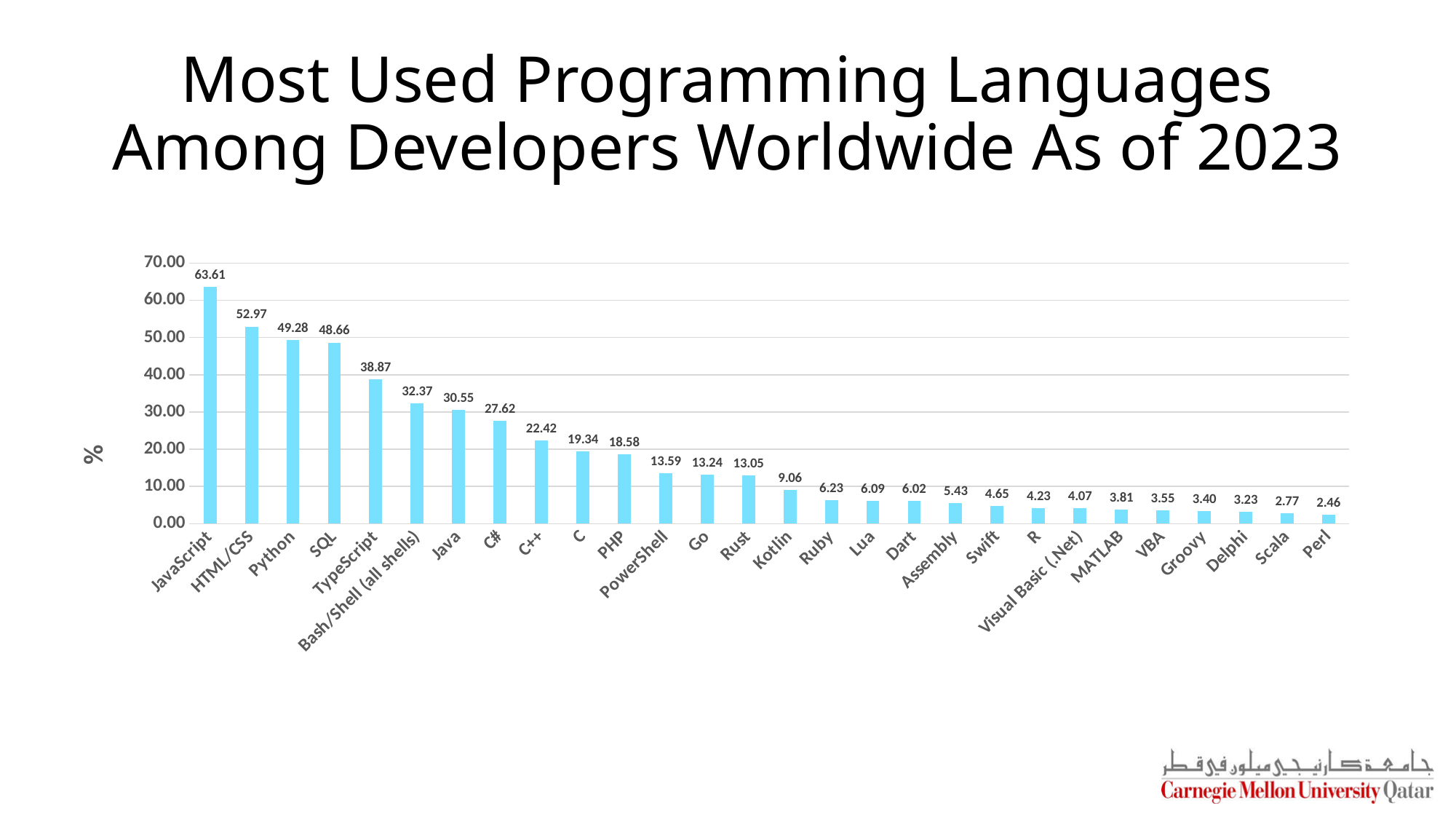
What is the value for Python? 49.28 How many programming languages are shown on the chart? 28 What is the label on the vertical axis of the chart? % What is the difference between the values for JavaScript and HTML/CSS? 10.64 Is the value for C++ greater or less than 20.00? greater What kind of chart is shown on the slide? Bar chart Which has a larger value, TypeScript or Bash/Shell (all shells)? TypeScript What is the value for Rust? 13.05 What is the value for Perl? 2.46 What is the difference between the values for Java and C#? 2.93 Which programming language has the highest value? JavaScript Which programming language has the lowest value? Perl